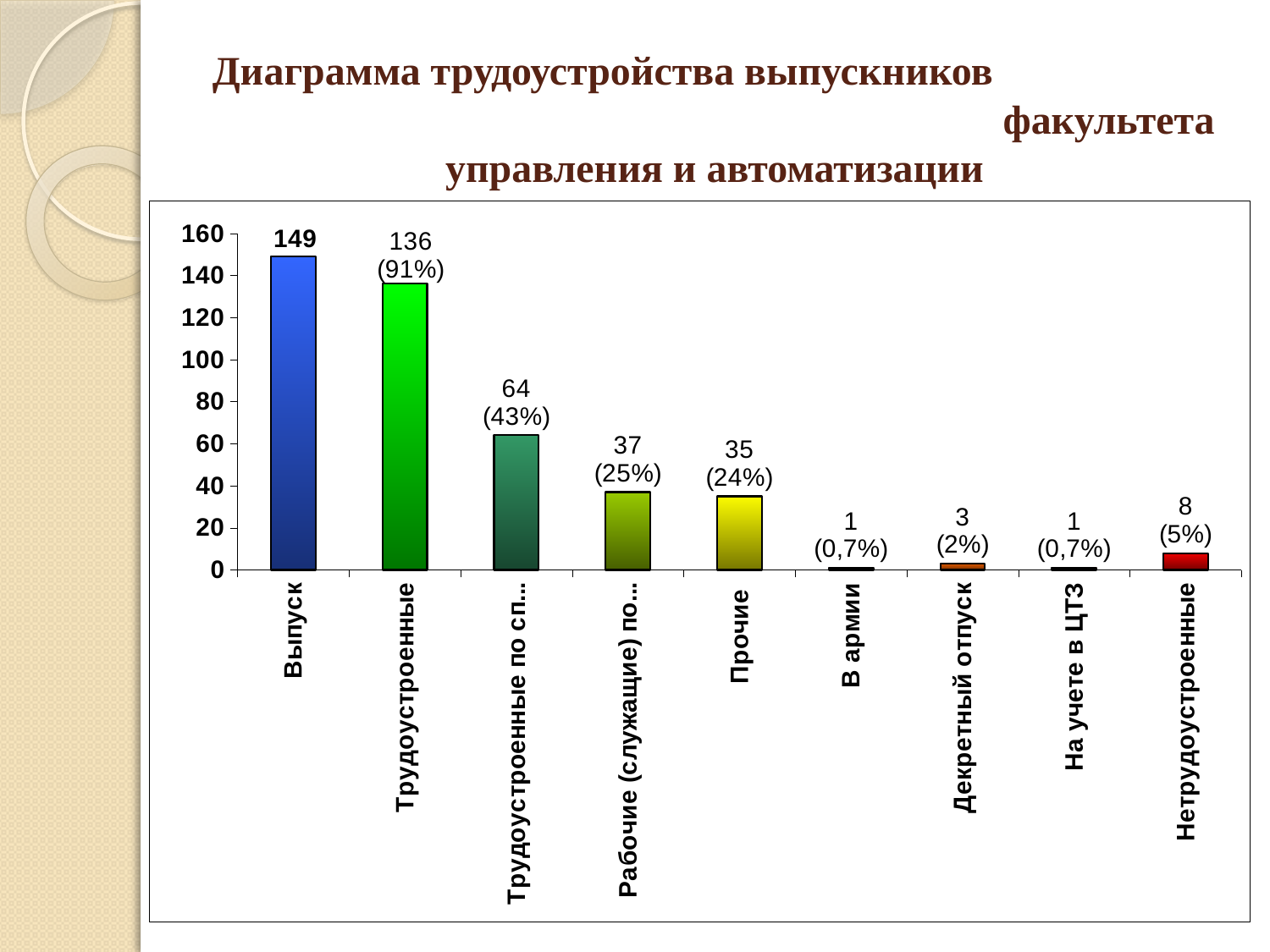
What is the value for Трудоустроенные? 136 What is the difference between the values for Выпуск and Трудоустроенные? 13 What is the value for Выпуск? 149 What is the value for Нетрудоустроенные? 8 What percentage is shown for Трудоустроенные? 91% What type of chart is shown on the slide? bar chart Which category has the highest value? Выпуск Is the value for Выпуск greater or less than 140? greater Which is larger, the value for Прочие or the value for Нетрудоустроенные? Прочие How many categories are shown on the x axis of the chart? 9 What percentage is shown for Декретный отпуск? 2% What is the value for На учете в ЦТЗ? 1